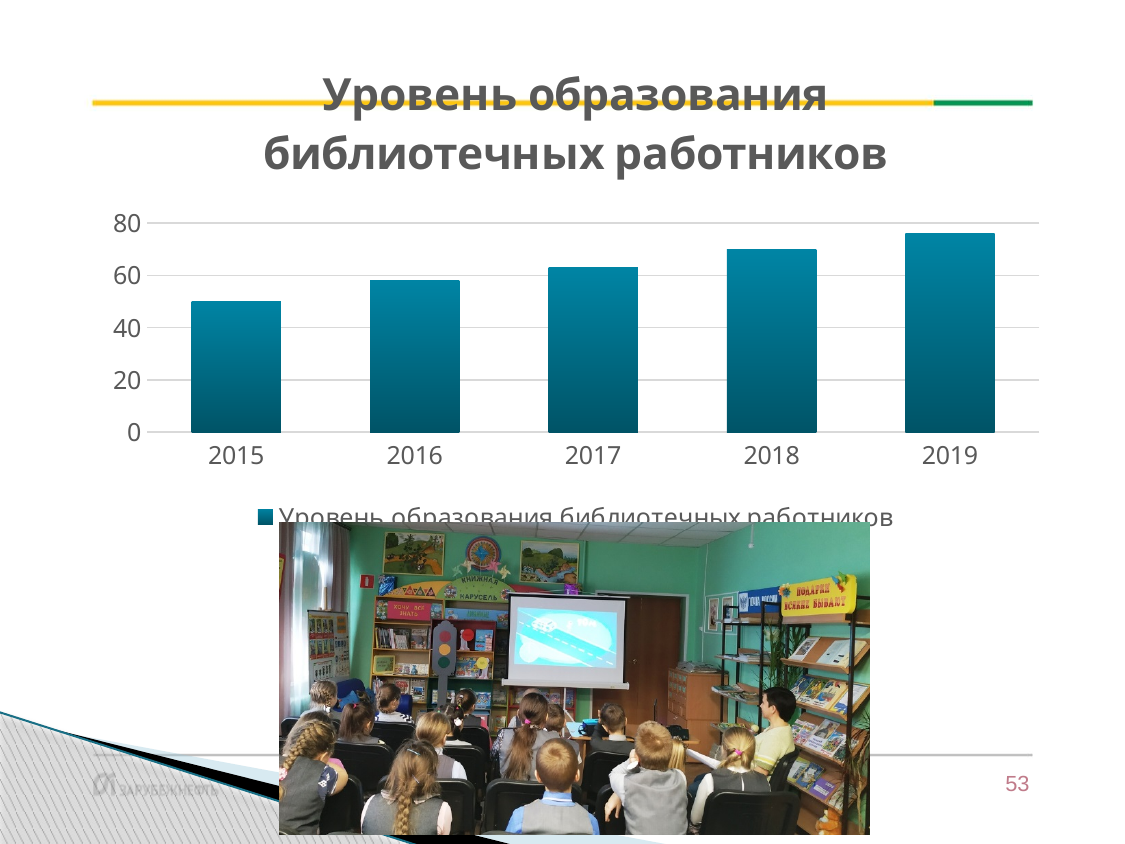
Is the value for 2015 greater or less than 40? greater Do the values rise or fall from 2015 to 2019? rise How many years are shown on the x axis of the chart? 5 Is the value for 2019 greater or less than 80? less Which year has the highest bar in the chart? 2019 What kind of chart is shown on the slide? bar chart How many series does the legend list? 1 Is the value for 2015 greater or less than 60? less Which is larger, the value for 2016 or the value for 2018? 2018 Which year has the lowest bar in the chart? 2015 What is the title of the chart? Уровень образования библиотечных работников